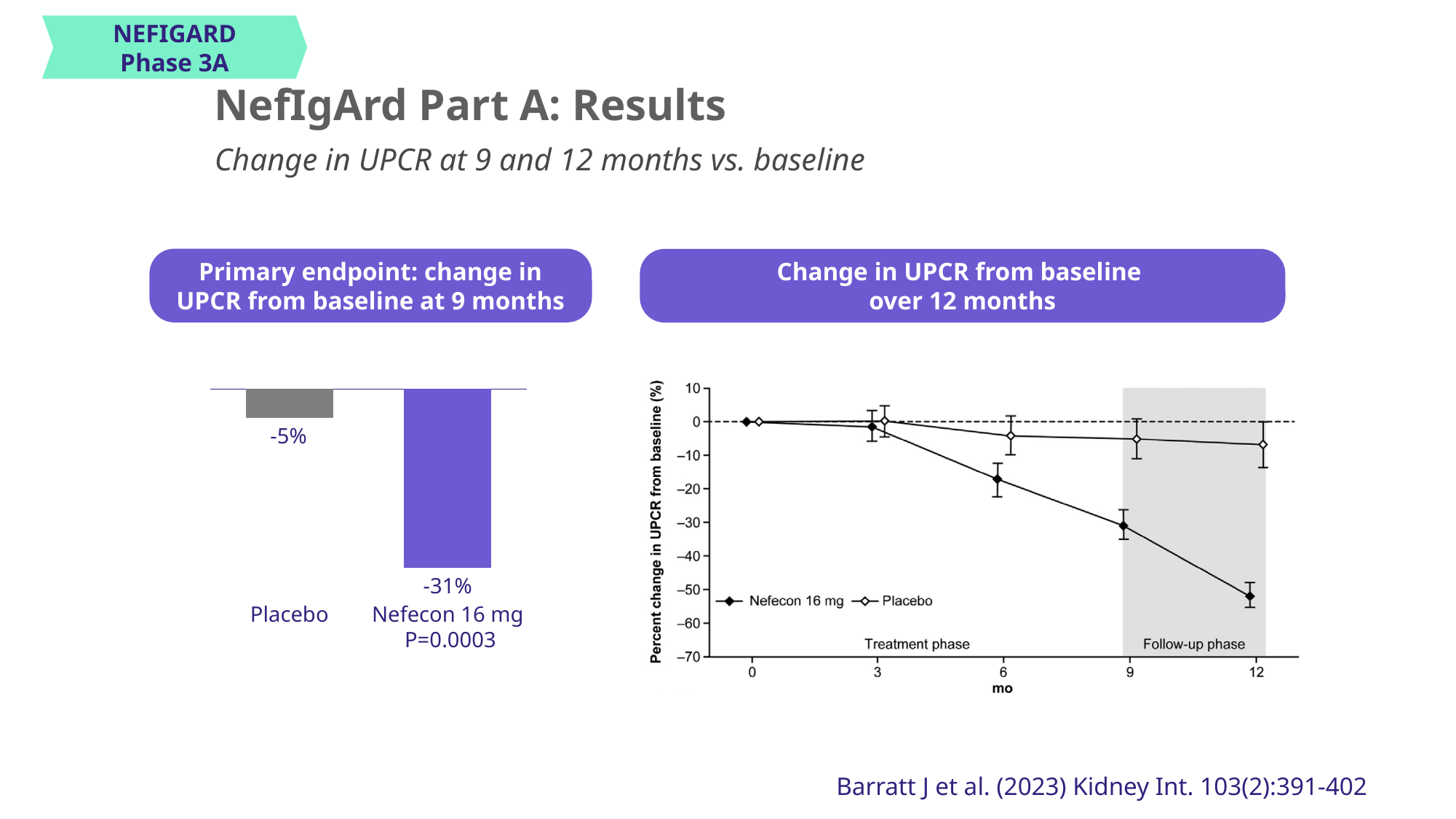
In the right chart (Change in UPCR from baseline over 12 months), is the value for Nefecon 16 mg at 12 months greater or less than -40? less In the left chart (Primary endpoint: change in UPCR from baseline at 9 months), what is the value for Nefecon 16 mg? -31% In the right chart (Change in UPCR from baseline over 12 months), how many time points are labelled on the x axis? 5 In the right chart (Change in UPCR from baseline over 12 months), is the value for Placebo at 12 months greater or less than -20? greater In the right chart (Change in UPCR from baseline over 12 months), does the Nefecon 16 mg line rise or fall from 0 to 12 months? Fall In the right chart (Change in UPCR from baseline over 12 months), how many series does the legend list? 2 In the left chart (Primary endpoint: change in UPCR from baseline at 9 months), what P value is shown under Nefecon 16 mg? P=0.0003 What kind of chart is the left chart (Primary endpoint: change in UPCR from baseline at 9 months)? Bar chart In the left chart (Primary endpoint: change in UPCR from baseline at 9 months), which group shows the larger reduction in UPCR? Nefecon 16 mg In the left chart (Primary endpoint: change in UPCR from baseline at 9 months), how many categories are shown? 2 In the left chart (Primary endpoint: change in UPCR from baseline at 9 months), what is the difference in percentage points between the Placebo and Nefecon 16 mg values? 26 percentage points In the left chart (Primary endpoint: change in UPCR from baseline at 9 months), what is the value for Placebo? -5%